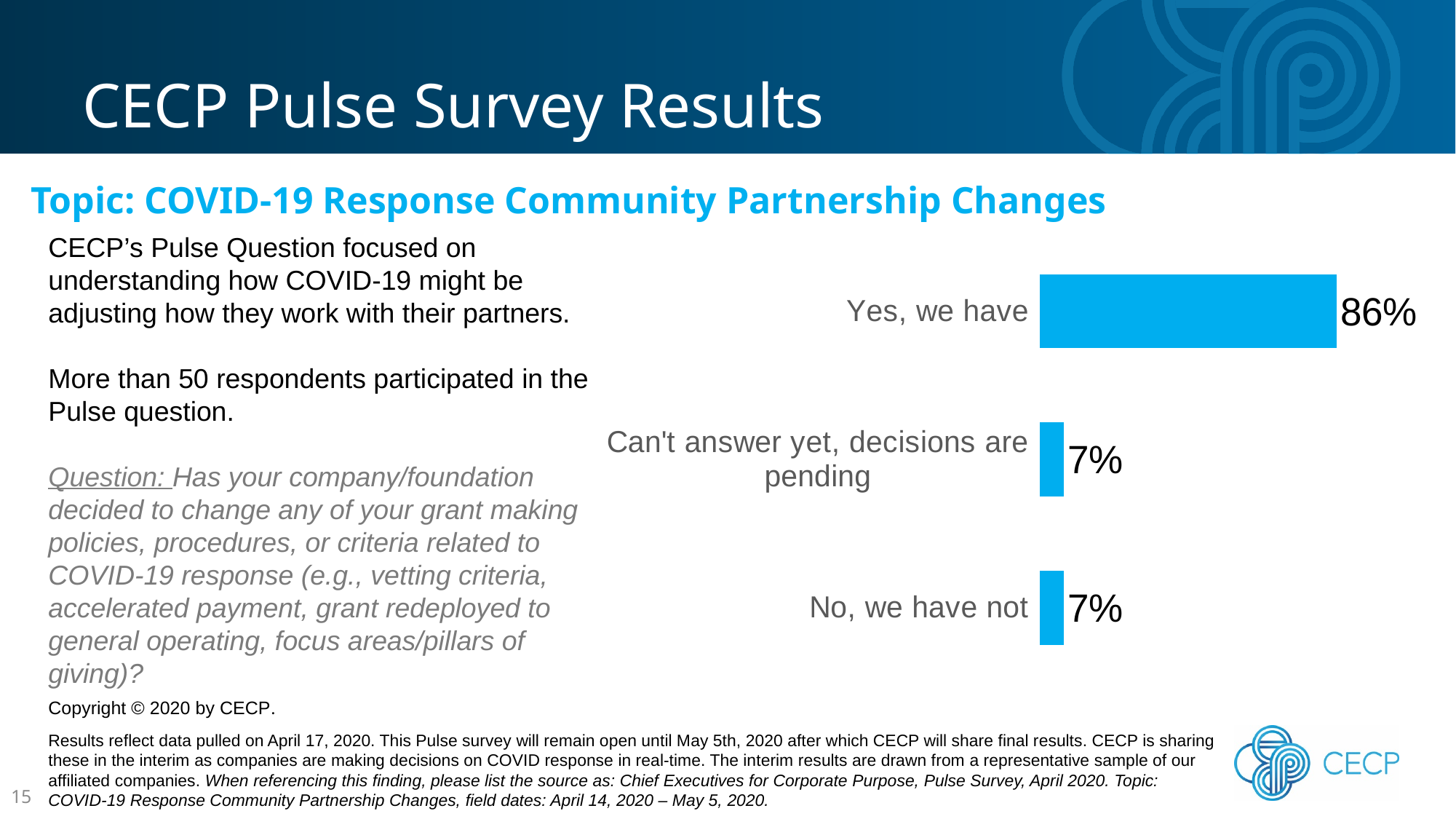
What is the difference in percentage points between "Yes, we have" and "No, we have not"? 79 Which response category is listed at the top of the chart? Yes, we have What percentage of respondents answered "Can't answer yet, decisions are pending"? 7% Do "Can't answer yet, decisions are pending" and "No, we have not" have the same percentage? Yes What kind of chart is shown on the slide? Bar chart What is the combined percentage of "Can't answer yet, decisions are pending" and "No, we have not"? 14% How many response categories are shown in the chart? 3 What colour are the bars in the chart? Blue What percentage of respondents answered "No, we have not"? 7% What percentage of respondents answered "Yes, we have"? 86% Which response category has the highest percentage? Yes, we have Which is larger: the value for "Yes, we have" or the value for "Can't answer yet, decisions are pending"? Yes, we have